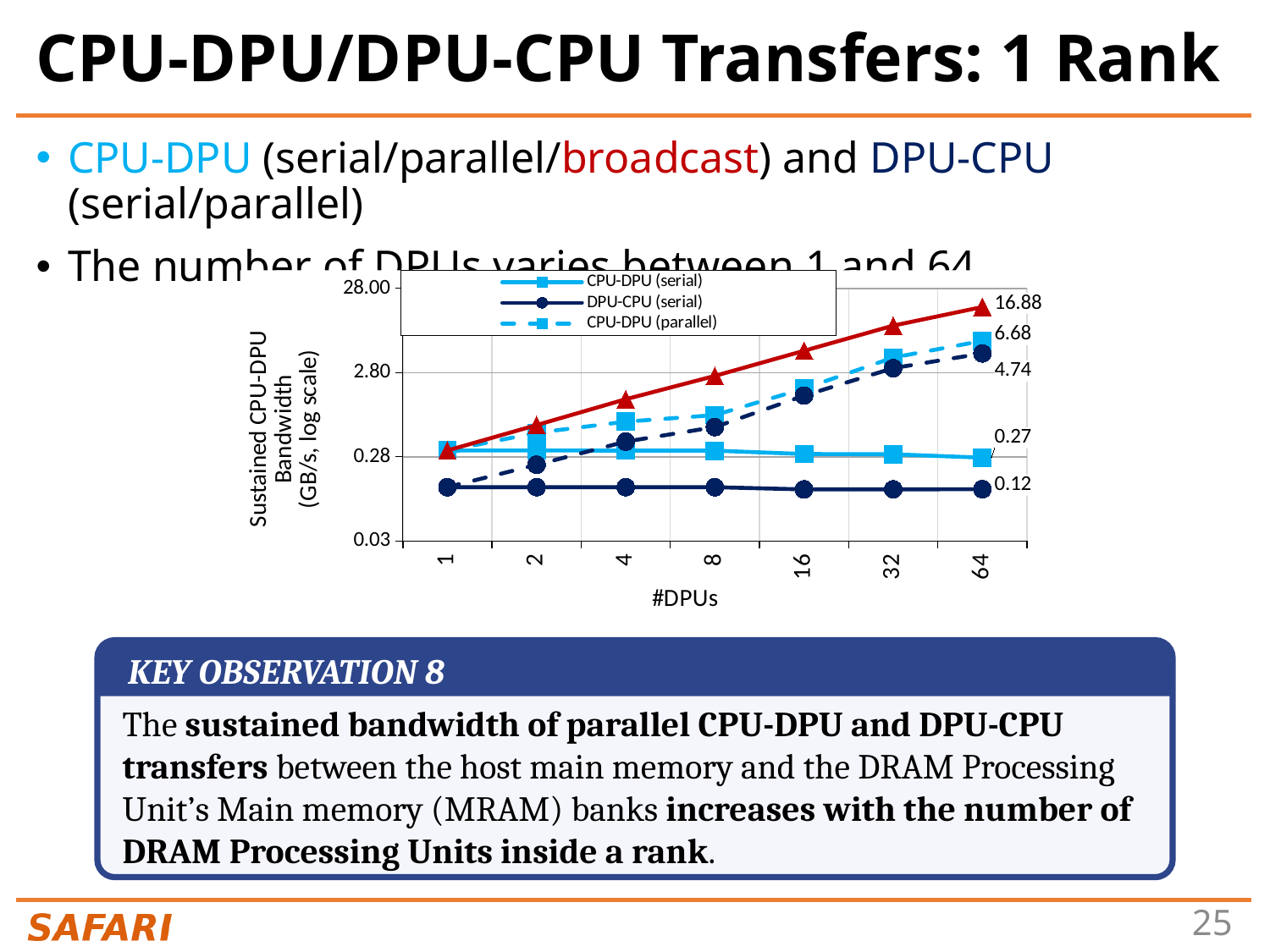
What is the label of the x axis of the chart? #DPUs What is the sustained bandwidth of DPU-CPU (serial) at 64 DPUs? 0.12 What is the sustained bandwidth of CPU-DPU (serial) at 64 DPUs? 0.27 At 64 DPUs, what is the difference between CPU-DPU (serial) and DPU-CPU (serial)? 0.15 What kind of chart is shown on the slide? line chart What is the sustained bandwidth of CPU-DPU (parallel) at 64 DPUs? 6.68 What is the highest data label printed on the chart? 16.88 At 64 DPUs, which is larger: CPU-DPU (serial) or DPU-CPU (serial)? CPU-DPU (serial) Is the value for DPU-CPU (serial) at 1 DPU greater or less than 0.28? less How many #DPUs values are plotted along the x axis? 7 Does the CPU-DPU (parallel) bandwidth rise or fall as the number of DPUs increases? rise At 64 DPUs, how much higher is CPU-DPU (parallel) than CPU-DPU (serial)? 6.41